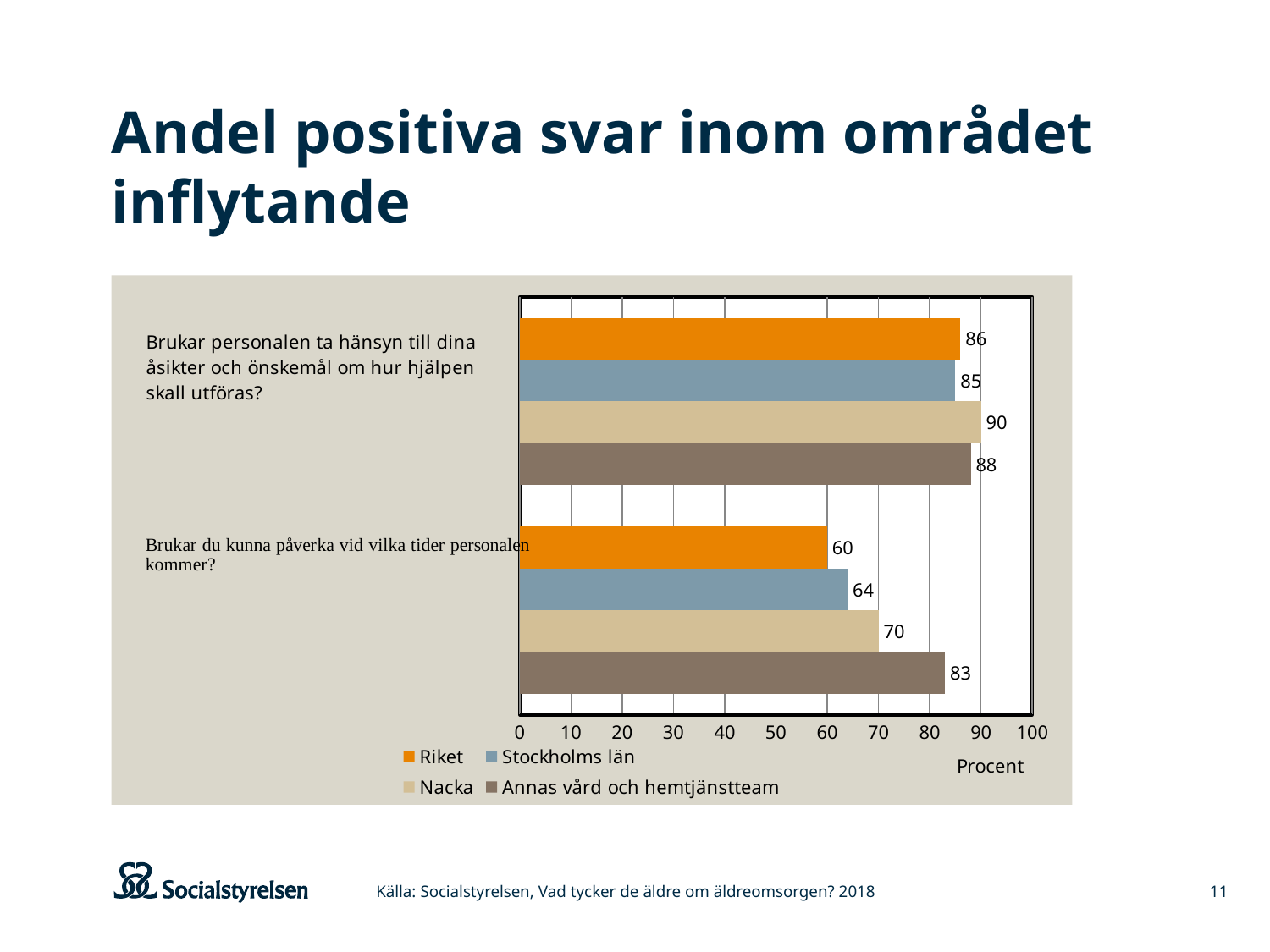
Which series has the lowest value on the question "Brukar du kunna påverka vid vilka tider personalen kommer?"? Riket What kind of chart is shown on the slide? Bar chart Which series has the highest value on the question "Brukar du kunna påverka vid vilka tider personalen kommer?"? Annas vård och hemtjänstteam What is the value for Annas vård och hemtjänstteam on the question "Brukar du kunna påverka vid vilka tider personalen kommer?"? 83 Which is larger on the question "Brukar du kunna påverka vid vilka tider personalen kommer?": Stockholms län or Annas vård och hemtjänstteam? Annas vård och hemtjänstteam What is the value for Nacka on the question "Brukar du kunna påverka vid vilka tider personalen kommer?"? 70 What is the value for Riket on the question "Brukar personalen ta hänsyn till dina åsikter och önskemål om hur hjälpen skall utföras?"? 86 What is the value for Stockholms län on the question "Brukar personalen ta hänsyn till dina åsikter och önskemål om hur hjälpen skall utföras?"? 85 Which series has the highest value on the question "Brukar personalen ta hänsyn till dina åsikter och önskemål om hur hjälpen skall utföras?"? Nacka What is the label on the horizontal axis of the chart? Procent What is the difference between Nacka and Riket on the question "Brukar du kunna påverka vid vilka tider personalen kommer?"? 10 How many series does the legend list? 4